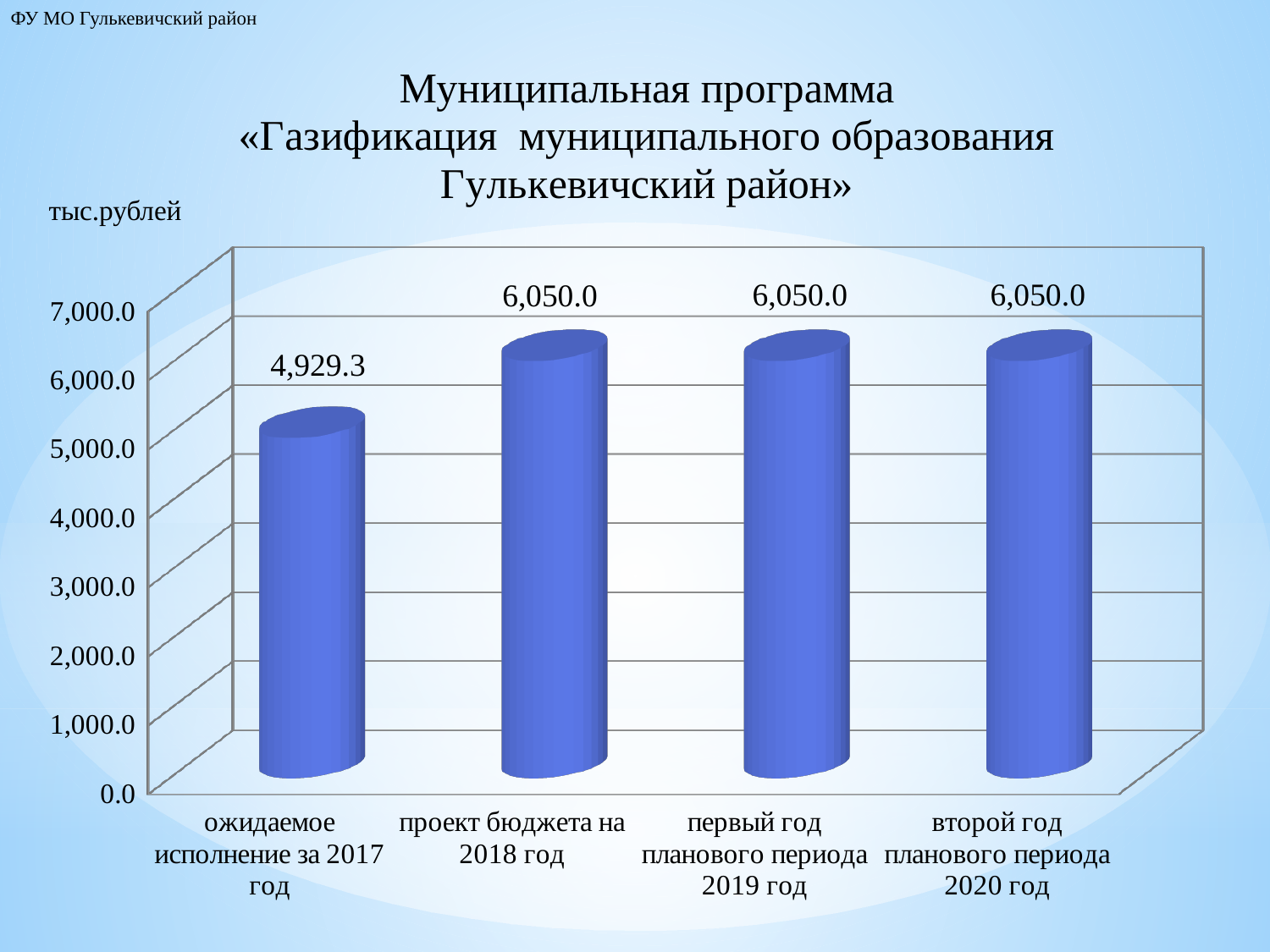
Do the values rise or fall from the first category to the second category? rise Is the value for 'первый год планового периода 2019 год' greater or less than 6,000.0? greater What is the value for 'второй год планового периода 2020 год'? 6,050.0 What unit is indicated above the chart's vertical axis? тыс.рублей What is the value for 'ожидаемое исполнение за 2017 год'? 4,929.3 What is the value for 'проект бюджета на 2018 год'? 6,050.0 Which is larger: the value for 'ожидаемое исполнение за 2017 год' or the value for 'первый год планового периода 2019 год'? первый год планового периода 2019 год What kind of chart is shown on the slide? bar chart Which category has the lowest value? ожидаемое исполнение за 2017 год How many categories are shown on the x axis? 4 Is the value for 'ожидаемое исполнение за 2017 год' greater or less than 5,000.0? less What is the difference between the value for 'проект бюджета на 2018 год' and the value for 'ожидаемое исполнение за 2017 год'? 1,120.7